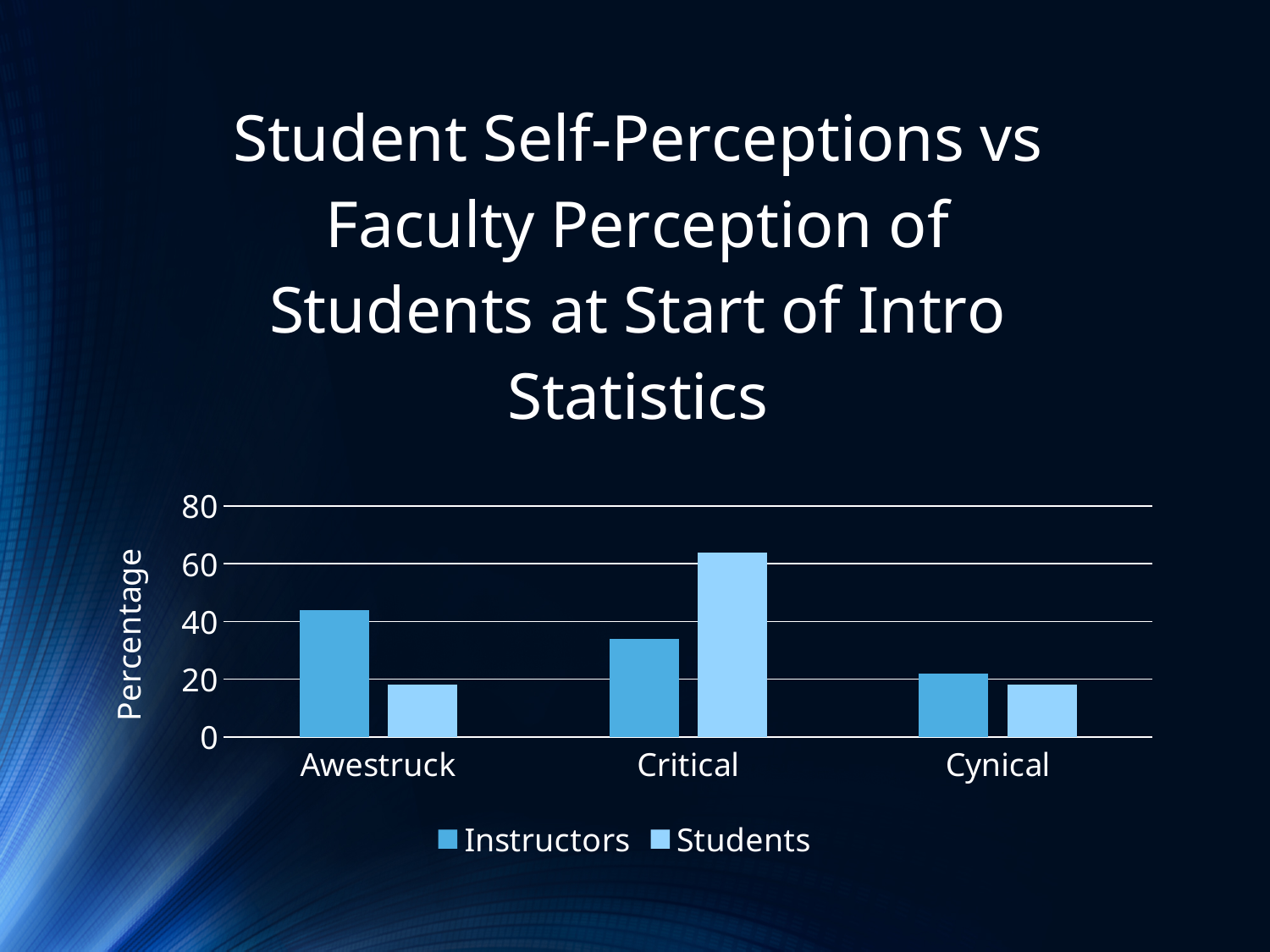
Which bar is the highest in the chart? Students, Critical What kind of chart is shown on the slide? bar chart For Critical, which series has the larger value, Instructors or Students? Students Is the Students value for Critical greater or less than 60? greater How many series does the chart's legend list? 2 What is the label on the vertical axis of the chart? Percentage How many categories are shown on the x axis of the chart? 3 For Awestruck, which series has the larger value, Instructors or Students? Instructors Is the Instructors value for Awestruck greater or less than 40? greater Is the Instructors value for Critical greater or less than 40? less What are the two series named in the chart's legend? Instructors and Students